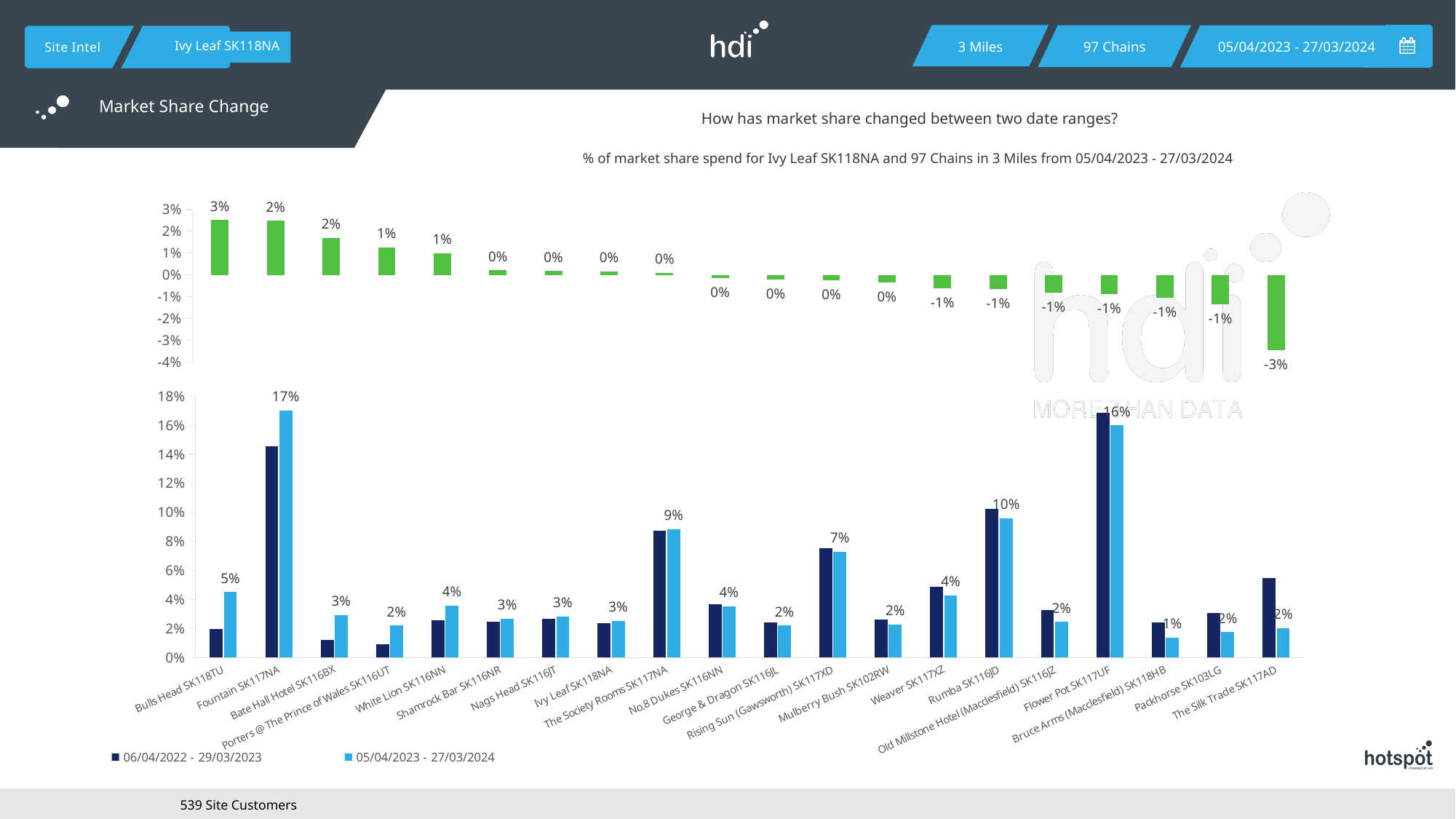
In the bottom chart, is the market share for Rumba SK116JD in the 06/04/2022 - 29/03/2023 period greater or less than 8%? greater In the top chart, which venue has the highest market share change? Bulls Head SK118TU In the bottom chart, which has the larger market share in the 06/04/2022 - 29/03/2023 period: Fountain SK117NA or Flower Pot SK117UF? Flower Pot SK117UF How many series does the legend of the bottom chart list? 2 In the top chart, which venue has the lowest market share change? The Silk Trade SK117AD In the top chart, what is the difference between the market share change for Bulls Head SK118TU and Fountain SK117NA? 1% In the bottom chart, which venue has the highest market share in the 05/04/2023 - 27/03/2024 period? Fountain SK117NA In the top chart, what is the market share change for Bulls Head SK118TU? 3% How many venues are shown along the x axis of the bottom chart? 20 In the top chart, what is the market share change for The Silk Trade SK117AD? -3% In the bottom chart, what is the market share for Fountain SK117NA in the 05/04/2023 - 27/03/2024 period? 17% What kind of chart is the top chart showing market share change? bar chart